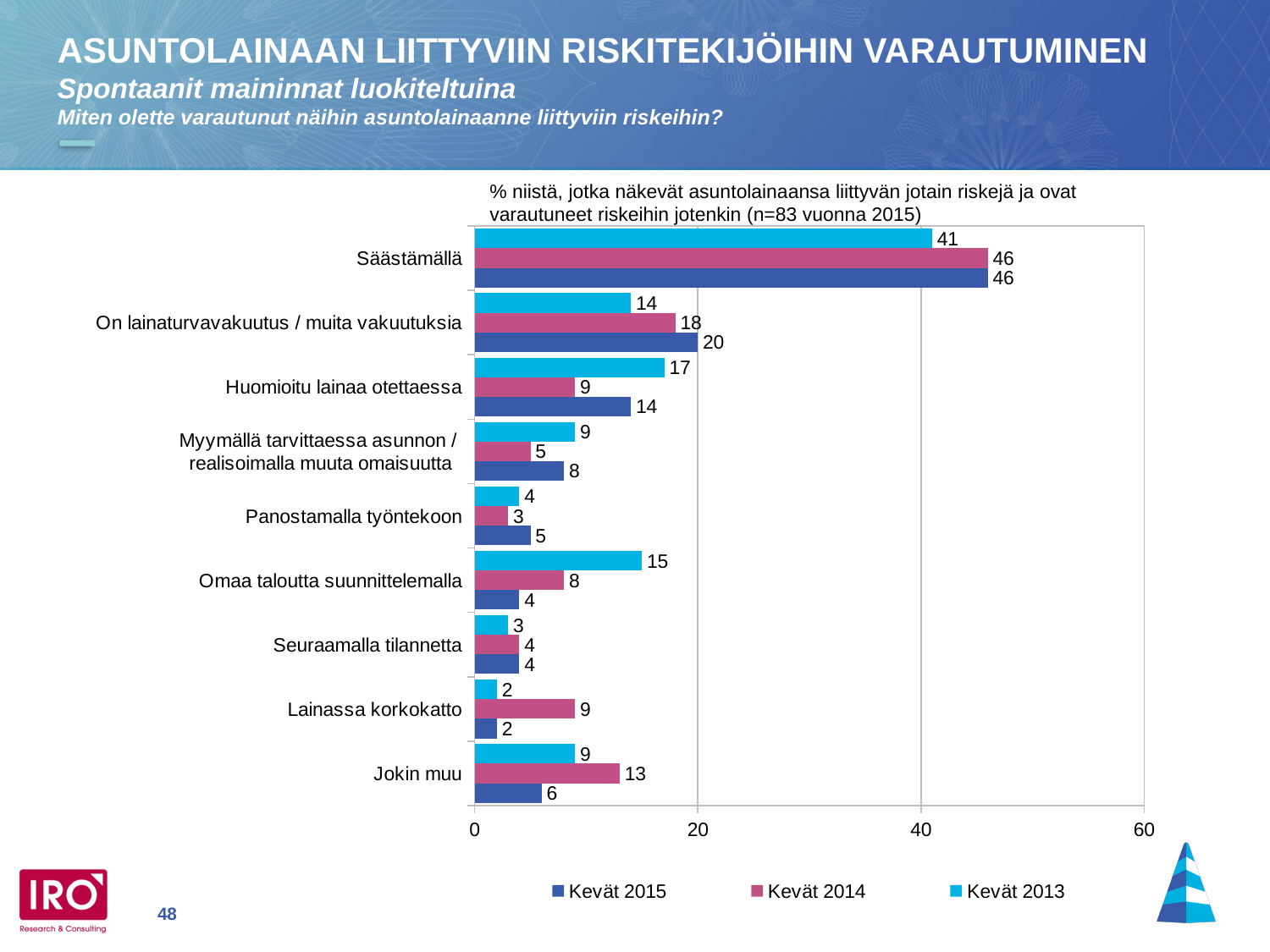
What is the value for Lainassa korkokatto in the Kevät 2014 series? 9 Which category has the highest value in the Kevät 2015 series? Säästämällä How many series does the legend list? 3 Which category has the lowest value in the Kevät 2013 series? Lainassa korkokatto Is the Kevät 2015 value for Säästämällä greater or less than 40? greater How many categories are shown on the chart? 9 What kind of chart is shown on the slide? Bar chart What is the value for Huomioitu lainaa otettaessa in the Kevät 2014 series? 9 What is the value for Säästämällä in the Kevät 2015 series? 46 What is the difference between the Kevät 2015 and Kevät 2013 values for On lainaturvavakuutus / muita vakuutuksia? 6 Which is larger for Jokin muu: the Kevät 2014 value or the Kevät 2015 value? Kevät 2014 What is the value for Omaa taloutta suunnittelemalla in the Kevät 2013 series? 15